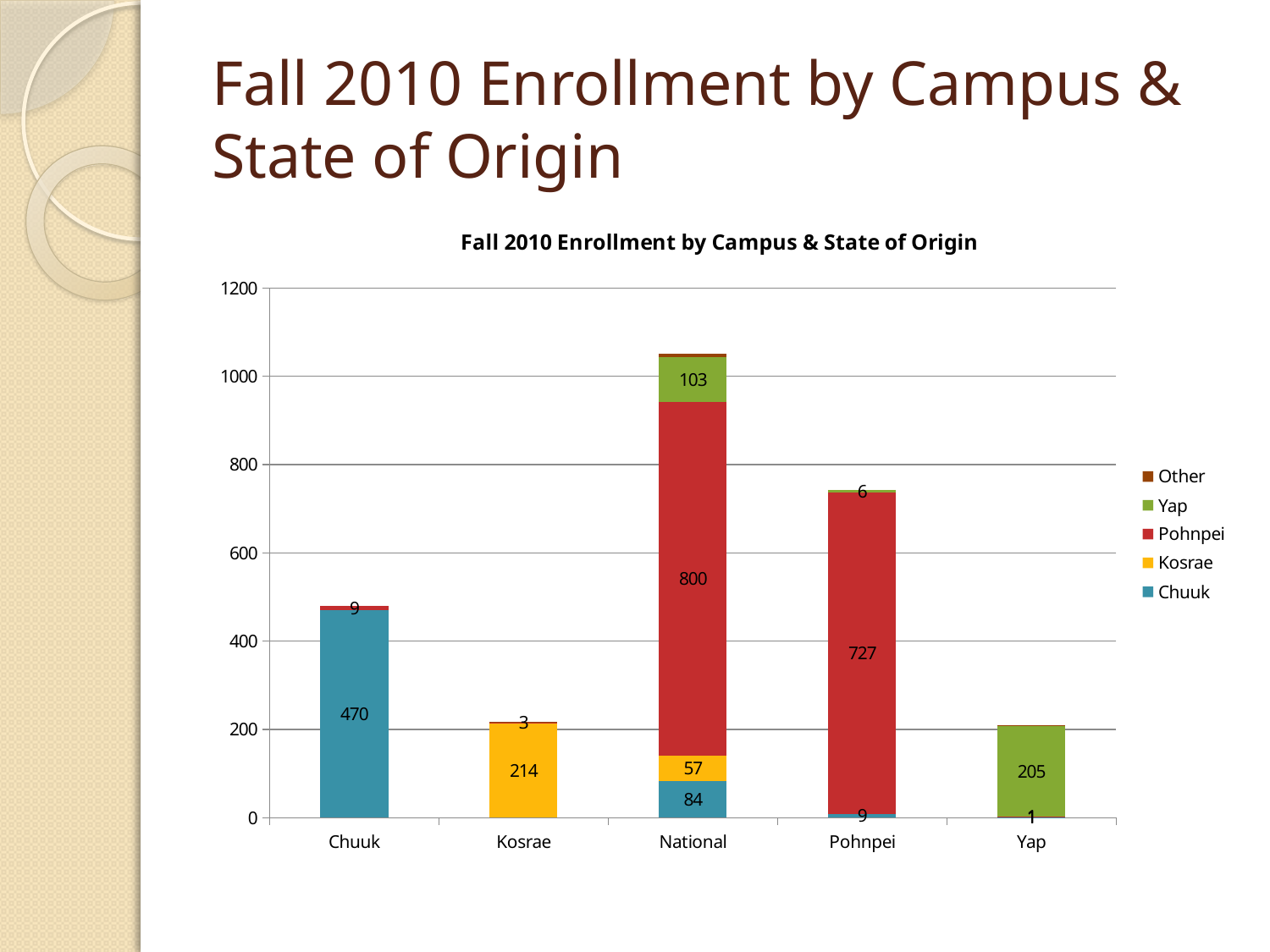
At the National campus, how many more Chuuk students are there than Kosrae students? 27 How many campuses are shown on the x axis? 5 How many series does the legend list? 5 What is the value for Yap students at the National campus? 103 How many students from Kosrae are enrolled at the Kosrae campus? 214 Is the total enrollment for the National campus greater or less than 1000? greater Which campus has the highest total enrollment? National How many students from Pohnpei are enrolled at the Pohnpei campus? 727 How many students from Chuuk are enrolled at the National campus? 84 What is the difference between the number of Pohnpei students at the National campus and at the Pohnpei campus? 73 What kind of chart is shown on the slide? Stacked bar chart Which is larger: the number of Chuuk students at the Chuuk campus or the number of Yap students at the Yap campus? Chuuk students at the Chuuk campus